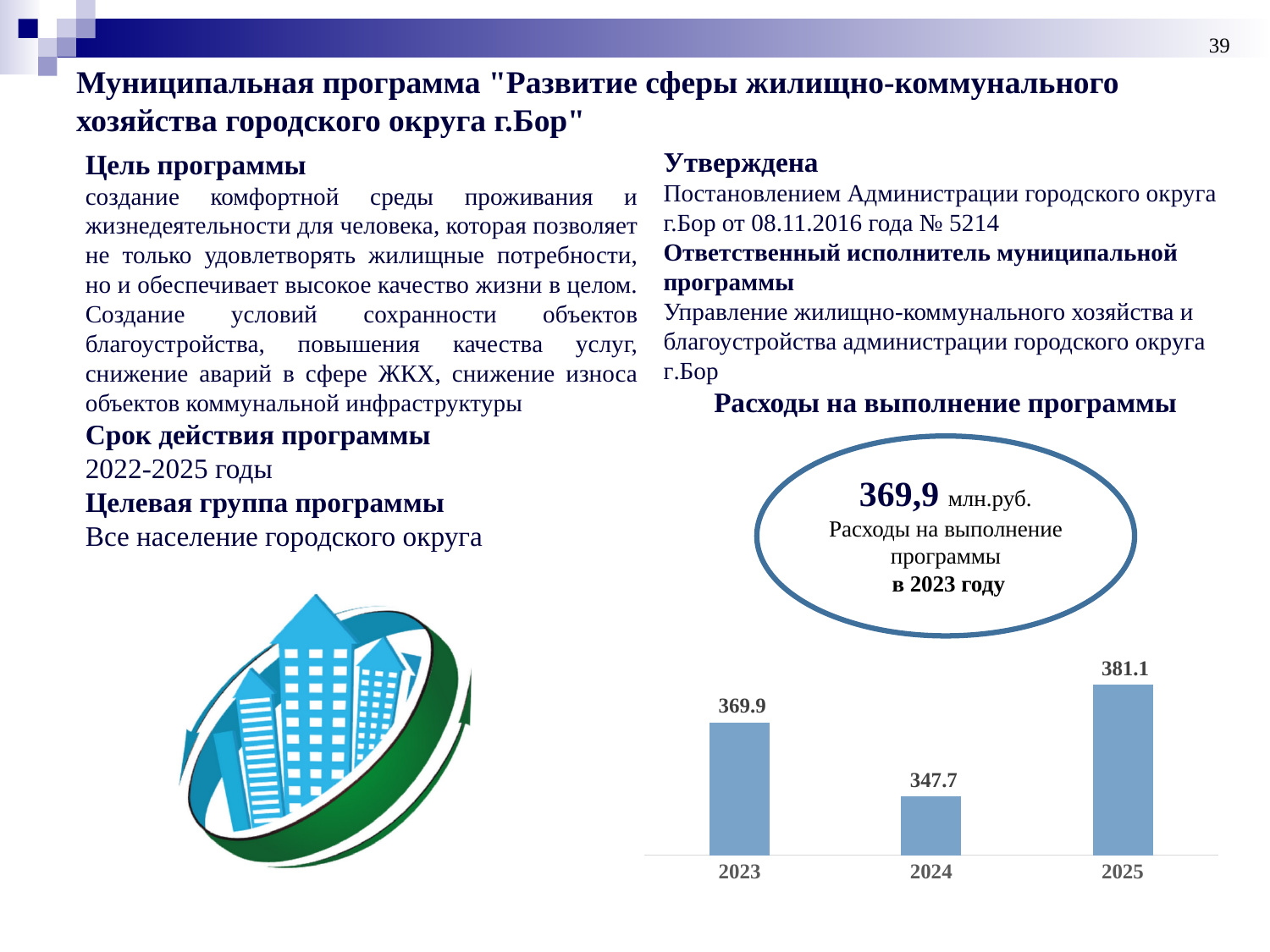
What is the difference between the values for 2023 and 2024? 22.2 What kind of chart is shown on the slide? bar chart Which year has the highest value in the chart? 2025 What is the value for 2025 in the chart? 381.1 What is the difference between the values for 2025 and 2024? 33.4 What is the title above the chart? Расходы на выполнение программы What is the value for 2024 in the chart? 347.7 Does the value fall or rise from 2023 to 2024? fall How many years are shown in the chart? 3 Which year has the lowest value in the chart? 2024 Which is larger, the value for 2023 or the value for 2025? 2025 What is the value for 2023 in the chart? 369.9